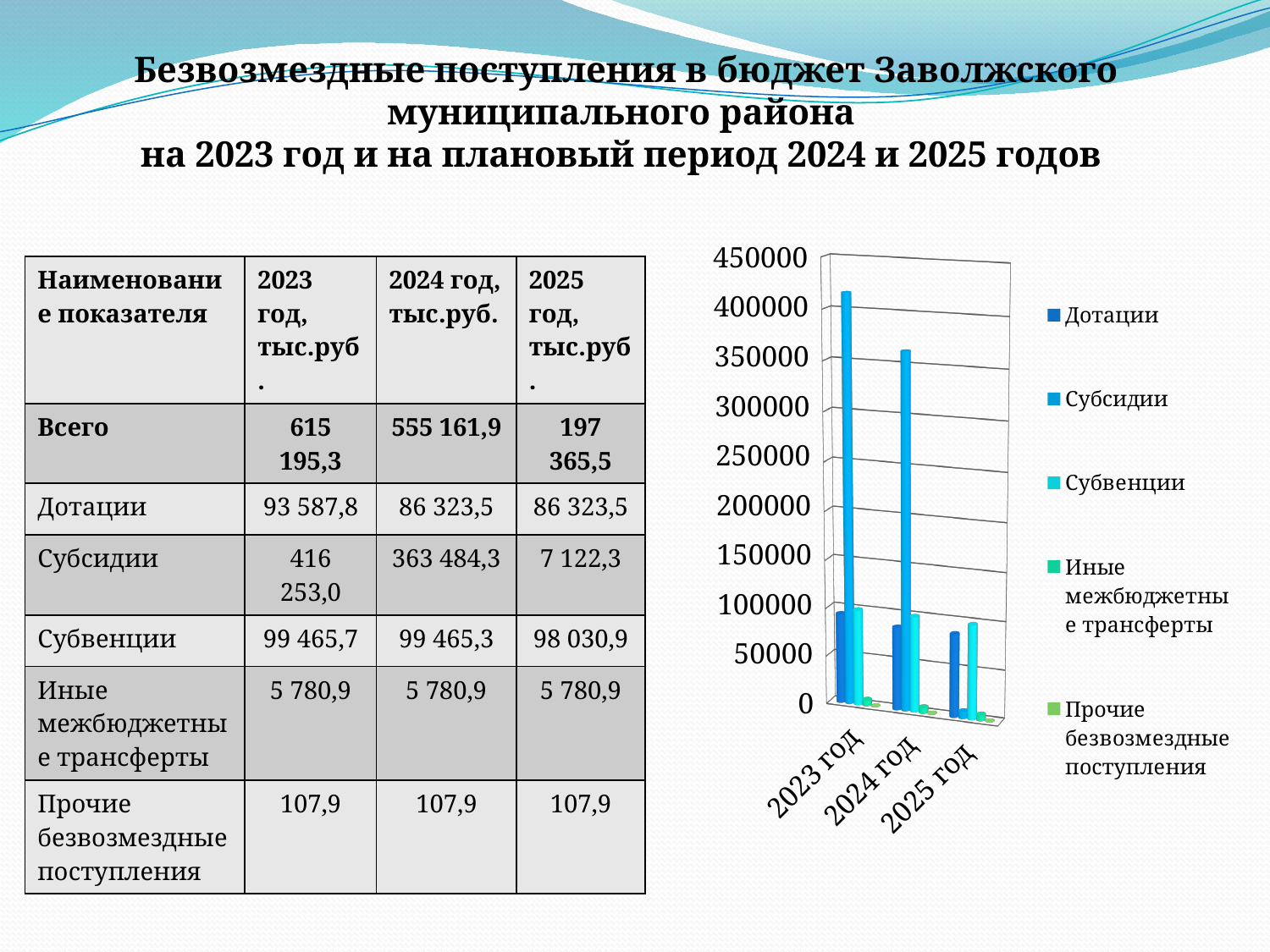
What is the highest value shown on the chart's vertical axis? 450000 How many year categories are shown on the x axis of the chart? 3 In which year is the Субсидии bar the highest? 2023 год Which series has the tallest bar for 2023 год? Субсидии Is the Дотации value for 2023 год greater or less than 100000? less Which is larger: Субсидии for 2023 год or Субсидии for 2025 год? 2023 год What kind of chart is shown on the slide? bar chart Which series has the shortest bar for 2023 год? Прочие безвозмездные поступления Is the Субсидии value for 2024 год greater or less than 400000? less Is the Субсидии value for 2023 год greater or less than 400000? greater How many series does the chart legend list? 5 Do the Субсидии values rise or fall from 2023 год to 2025 год? fall